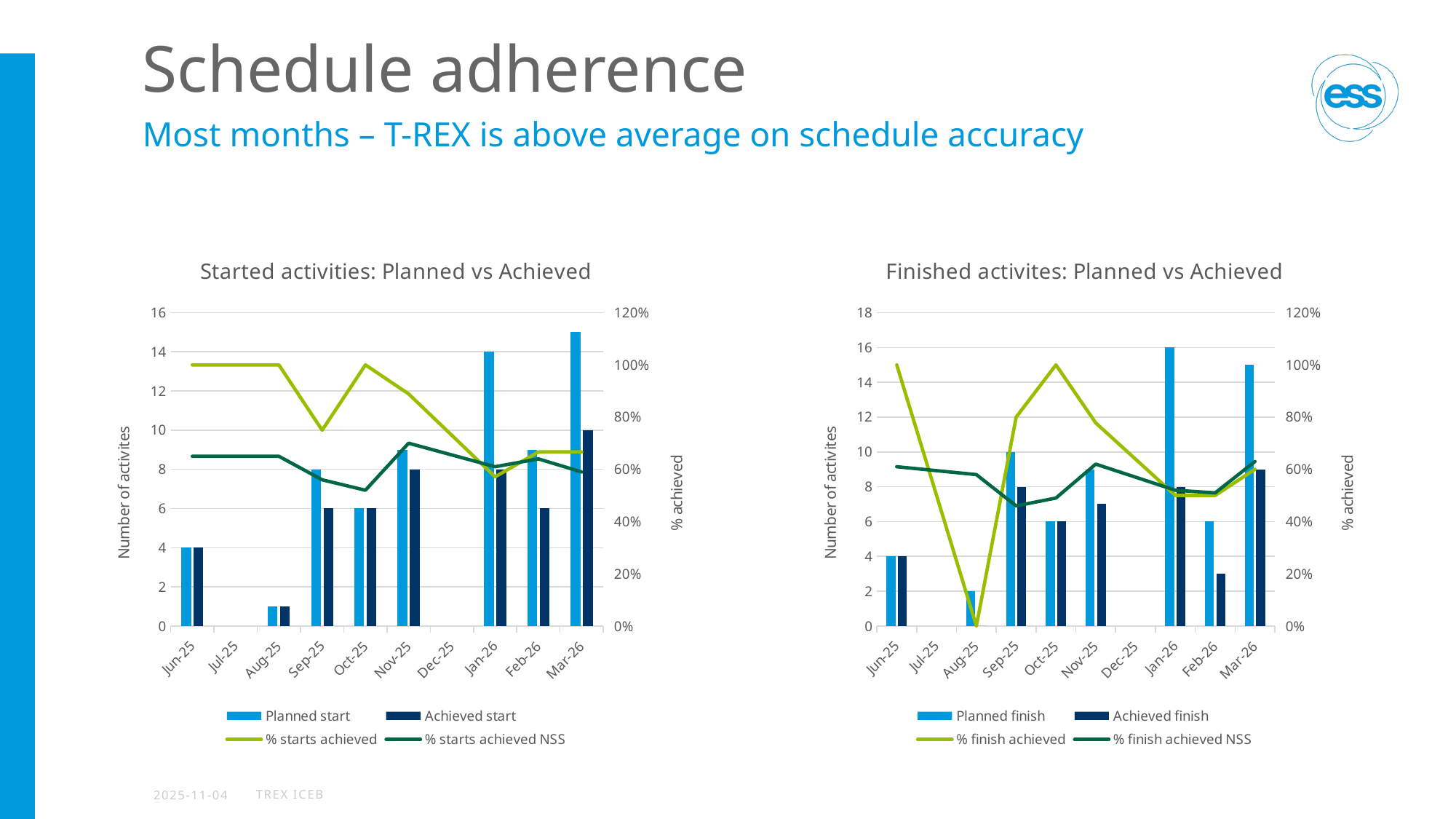
On the 'Started activities: Planned vs Achieved' chart, what is the Planned start value for Jan-26? 14 On the 'Finished activites: Planned vs Achieved' chart, what is the % finish achieved value for Aug-25? 0% On the 'Started activities: Planned vs Achieved' chart, is the % starts achieved NSS value for Jun-25 greater or less than 80%? less On the 'Finished activites: Planned vs Achieved' chart, which is larger: the Planned finish for Jan-26 or the Planned finish for Feb-26? Jan-26 On the 'Finished activites: Planned vs Achieved' chart, what is the difference between the Planned finish values for Jan-26 and Sep-25? 6 On the 'Finished activites: Planned vs Achieved' chart, what is the Planned finish value for Jan-26? 16 How many series does the legend of the 'Started activities: Planned vs Achieved' chart list? 4 On the 'Finished activites: Planned vs Achieved' chart, what is the Achieved finish value for Sep-25? 8 On the 'Started activities: Planned vs Achieved' chart, which month has the highest Planned start bar? Mar-26 On the 'Started activities: Planned vs Achieved' chart, what is the Planned start value for Jun-25? 4 How many months are shown on the x axis of the 'Finished activites: Planned vs Achieved' chart? 10 On the 'Started activities: Planned vs Achieved' chart, what is the % starts achieved value for Jun-25? 100%